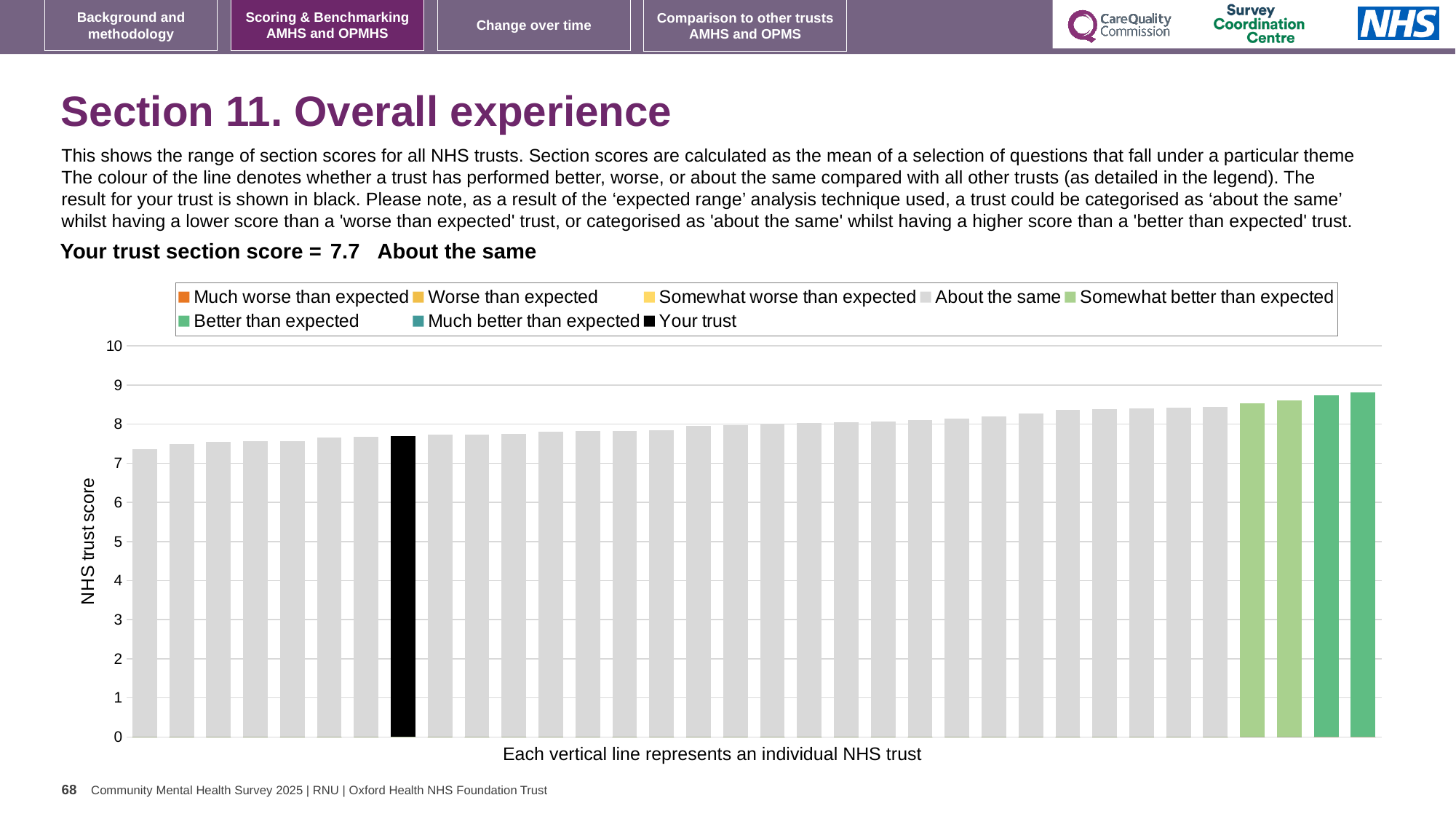
How many bars in the chart are coloured green (better than expected categories)? 4 Is the value of the lowest bar in the chart greater or less than 7? greater Do the bar values rise or fall from left to right across the chart? Rise What kind of chart is shown on the slide? Bar chart What is the section score for your trust shown on the slide? 7.7 What is the label on the vertical axis of the chart? NHS trust score How many entries does the chart legend list? 8 What colour is the bar representing your trust? Black What is the maximum value shown on the vertical axis? 10 How is your trust's section score categorised compared with other trusts? About the same Is the value for your trust (the black bar) greater or less than 7? greater Is the value of the highest bar in the chart greater or less than 9? less